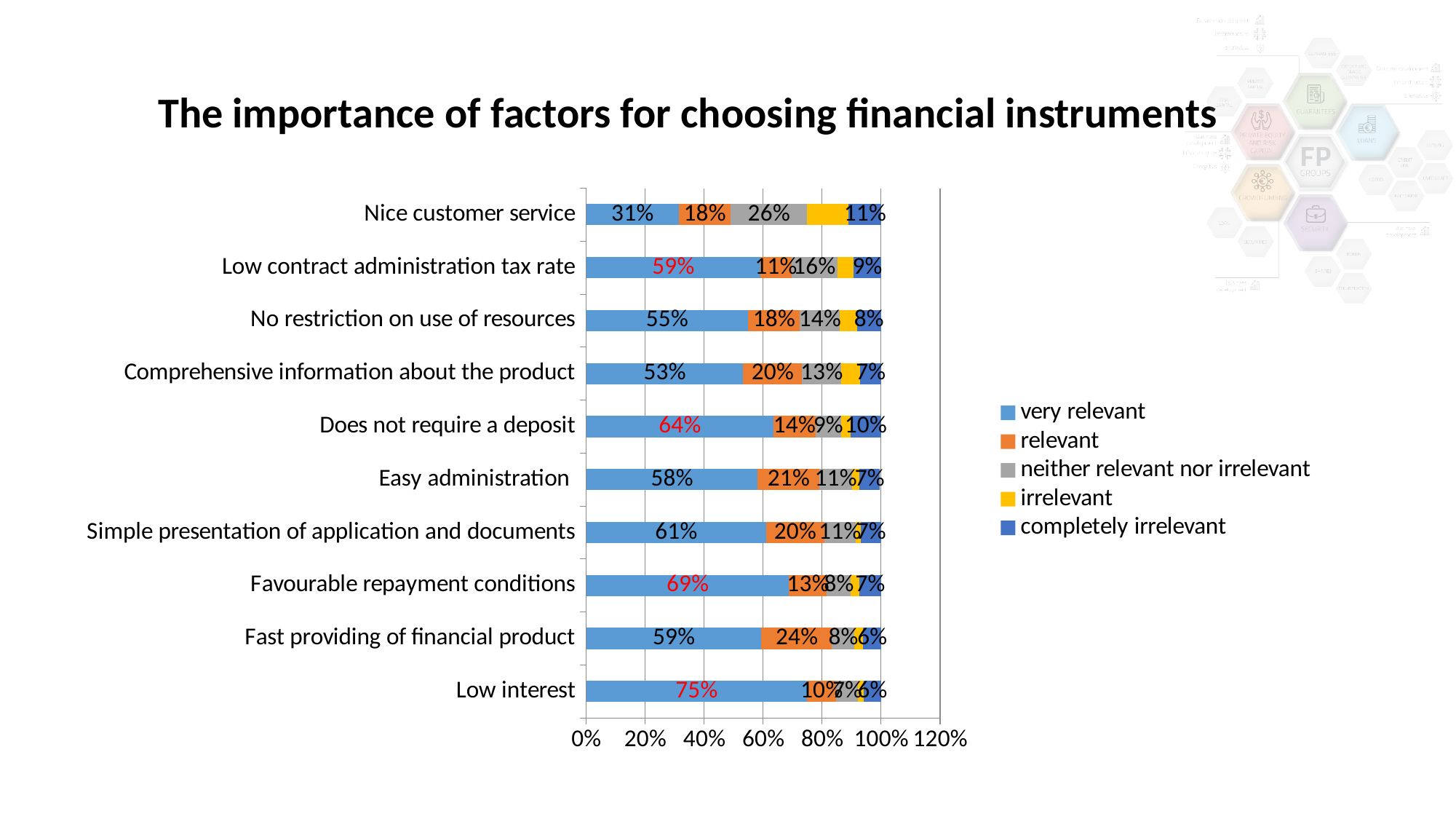
What is the "neither relevant nor irrelevant" value for "Nice customer service"? 26% Is the "very relevant" value for "No restriction on use of resources" greater or less than 40%? greater What kind of chart is shown on the slide? Stacked bar chart Which factor has the lowest "very relevant" share? Nice customer service What percentage of respondents rated "Low interest" as very relevant? 75% How many series does the legend list? 5 Which has a larger "very relevant" share: "Easy administration" or "Simple presentation of application and documents"? Simple presentation of application and documents Which legend entry is shown in orange? relevant What is the difference between the "very relevant" values for "Favourable repayment conditions" and "Does not require a deposit"? 5% What is the "relevant" value for "Fast providing of financial product"? 24% How many factors are listed on the chart? 10 Which factor has the highest "very relevant" share? Low interest